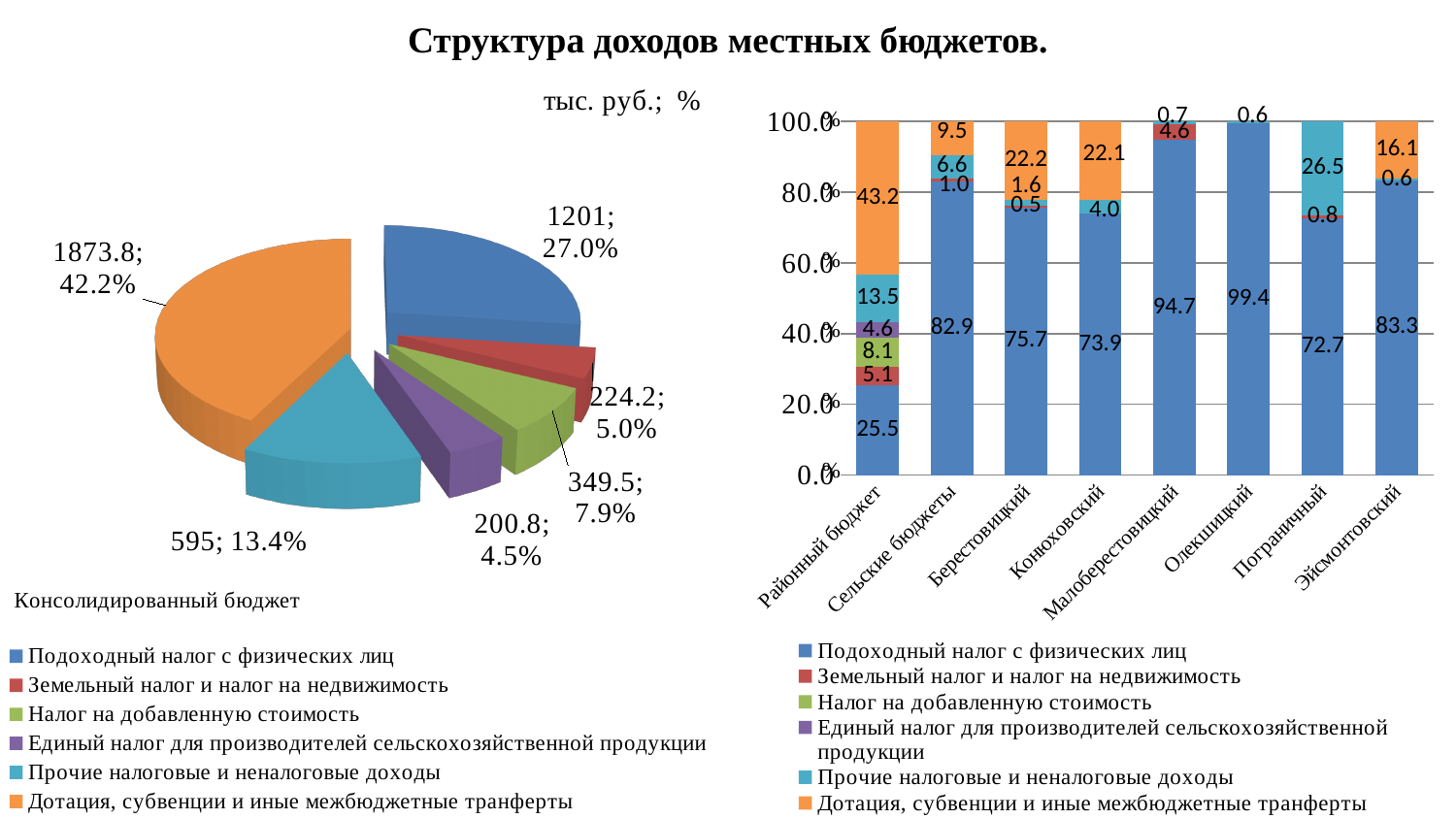
In the pie chart on the left, which category has the largest slice? Дотация, субвенции и иные межбюджетные трансферты In the stacked bar chart on the right, what is the value of 'Подоходный налог с физических лиц' for Олекшицкий? 99.4 In the stacked bar chart on the right, which category has the highest value for 'Подоходный налог с физических лиц'? Олекшицкий What type of chart is the chart on the left of the slide? Pie chart In the pie chart on the left, which category has the smallest slice? Единый налог для производителей сельскохозяйственной продукции How many categories are shown on the x axis of the stacked bar chart on the right? 8 In the pie chart on the left, what value is shown for 'Подоходный налог с физических лиц'? 1201 In the stacked bar chart on the right, what is the difference between the 'Подоходный налог с физических лиц' values for Сельские бюджеты and Районный бюджет? 57.4 How many series does the legend of the stacked bar chart on the right list? 6 In the stacked bar chart on the right, what is the value of 'Дотация, субвенции и иные межбюджетные трансферты' for Районный бюджет? 43.2 In the stacked bar chart on the right, which has the larger value for 'Дотация, субвенции и иные межбюджетные трансферты': Берестовицкий or Эйсмонтовский? Берестовицкий In the pie chart on the left, what share does 'Дотация, субвенции и иные межбюджетные трансферты' have? 42.2%